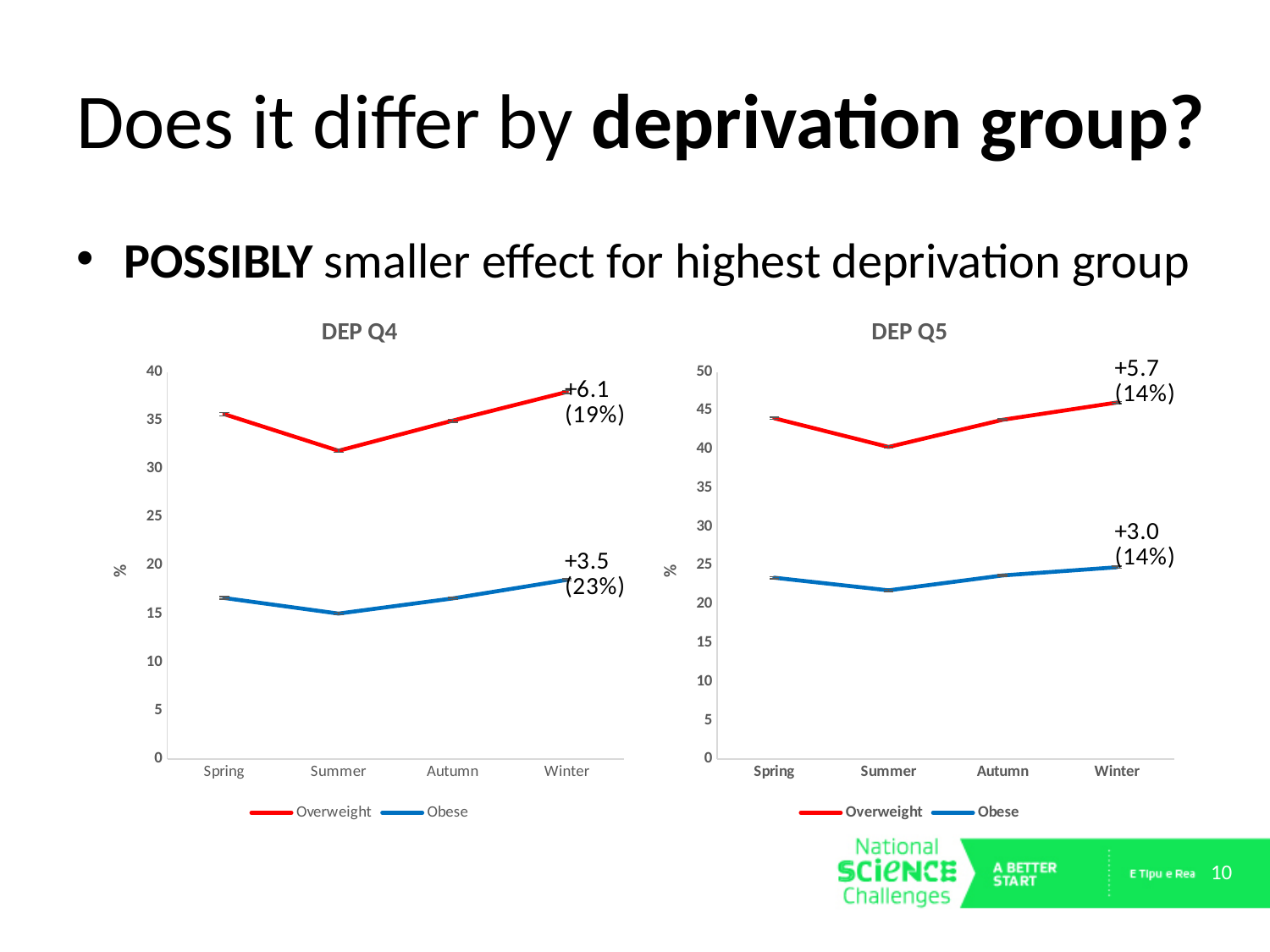
In the DEP Q4 chart, is the Overweight value for Summer greater or less than 35? less In the DEP Q4 chart, in which season is the Overweight line lowest? Summer What type of chart is the DEP Q4 chart? line chart In the DEP Q5 chart, in which season is the Obese line lowest? Summer In the DEP Q5 chart, which series has higher values in every season, Overweight or Obese? Overweight How many seasons are plotted on the x axis of the DEP Q4 chart? 4 In the DEP Q5 chart, is the Obese value for Spring greater or less than 25? less In the DEP Q4 chart, in which season is the Overweight line highest? Winter How many series does the legend of the DEP Q5 chart list? 2 In the DEP Q5 chart, what change annotation is printed next to the Winter end of the Obese line? +3.0 (14%) In the DEP Q4 chart, is the Obese value for Winter greater or less than 20? less In the DEP Q4 chart, what change annotation is printed next to the Winter end of the Overweight line? +6.1 (19%)